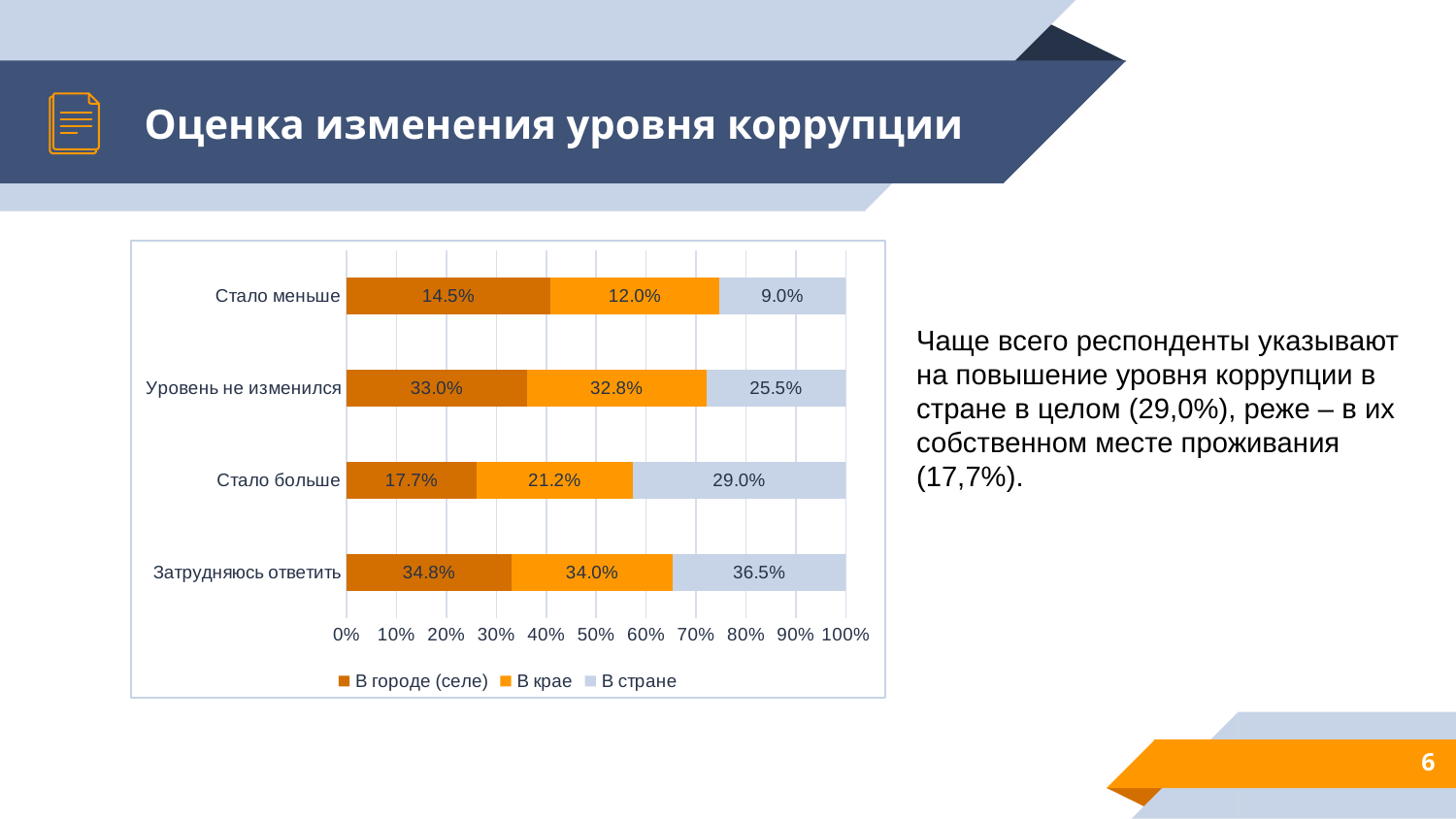
What kind of chart is shown on the slide? Stacked bar chart In the «Стало меньше» category, which is larger: the «В городе (селе)» value or the «В крае» value? В городе (селе) In the «Стало больше» category, how much larger is the «В стране» value than the «В городе (селе)» value? 11.3 percentage points How many categories are shown on the chart? 4 What is the value for «В городе (селе)» in the «Затрудняюсь ответить» category? 34.8% What is the value for «В крае» in the «Уровень не изменился» category? 32.8% Which category has the highest value for the «В стране» series? Затрудняюсь ответить What is the value for «В стране» in the «Стало больше» category? 29.0% Which category has the lowest value for the «В стране» series? Стало меньше How many series does the legend list? 3 In the «Уровень не изменился» category, what is the difference between the «В городе (селе)» value and the «В стране» value? 7.5 percentage points What are the three series named in the legend? В городе (селе), В крае, В стране